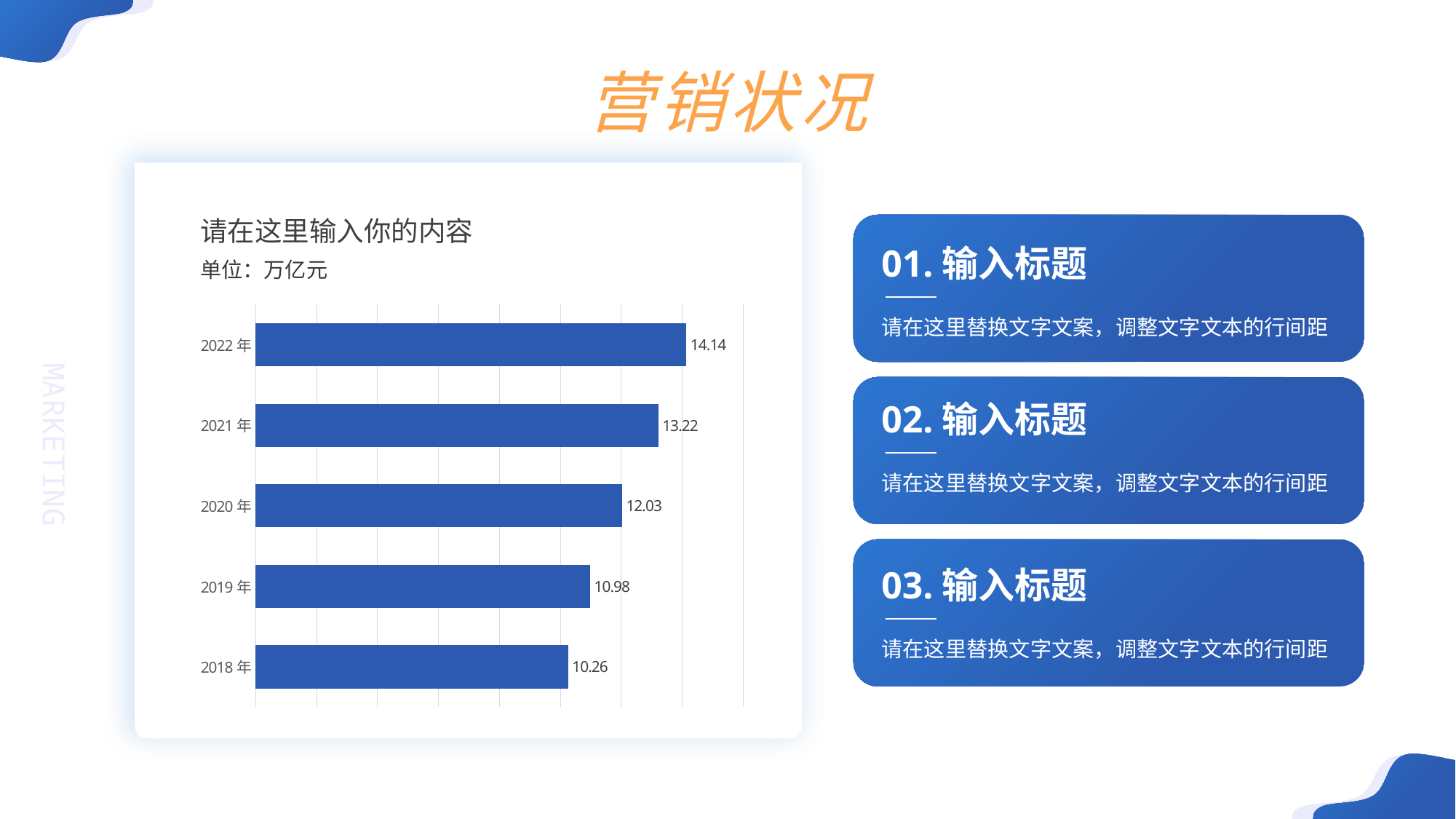
What is the value for 2019 年? 10.98 How many years are shown in the chart? 5 What is the difference between the values for 2020 年 and 2018 年? 1.77 What unit is stated above the chart? 万亿元 What kind of chart is shown on the slide? bar chart What is the value for 2018 年? 10.26 Which year has the highest value? 2022 年 What is the difference between the values for 2022 年 and 2021 年? 0.92 Do the values rise or fall from 2018 年 to 2022 年? rise Which year has the lowest value? 2018 年 What is the value for 2022 年? 14.14 Which is larger, the value for 2021 年 or the value for 2020 年? 2021 年